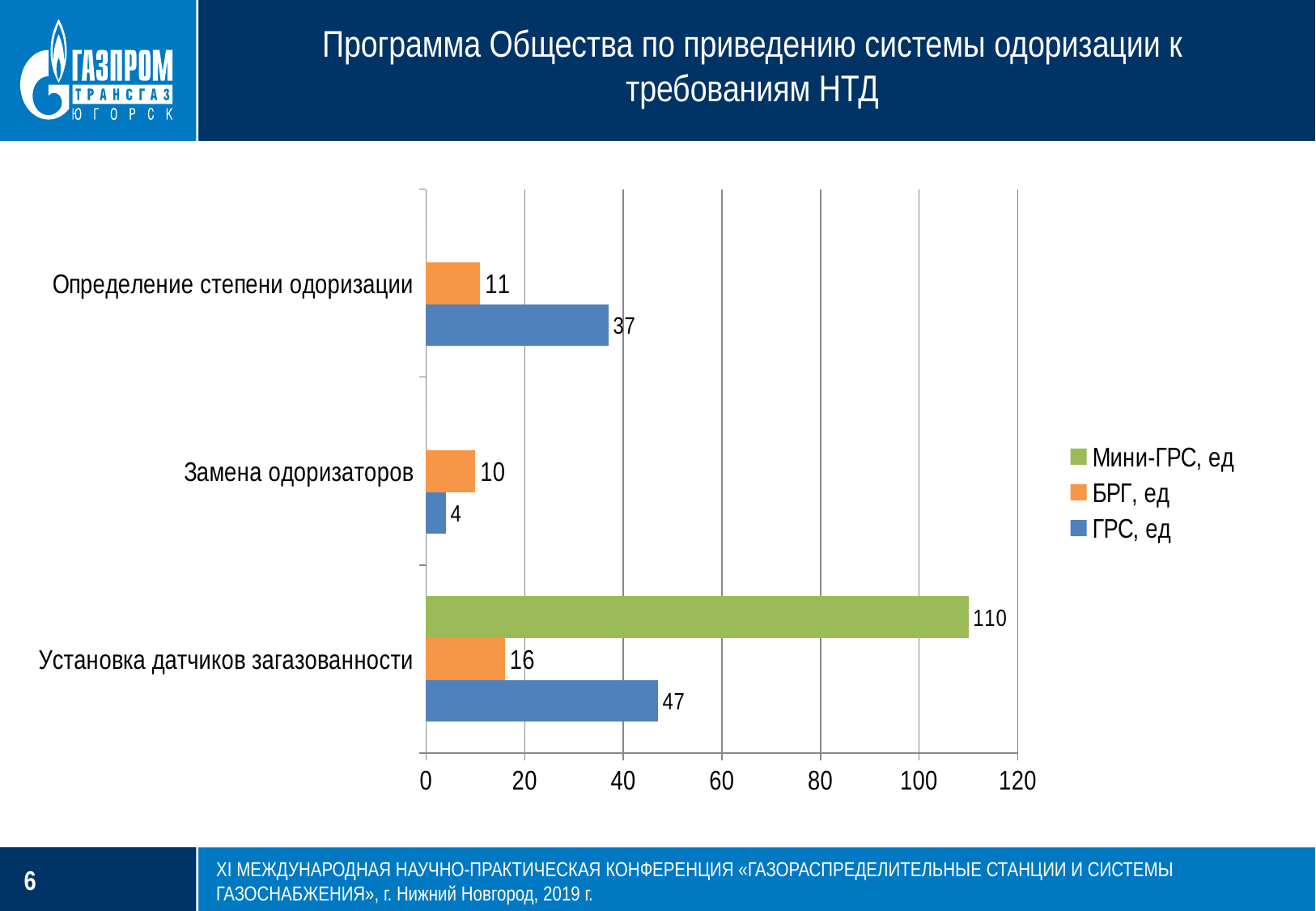
How many categories are shown on the chart? 3 What kind of chart is shown on the slide? bar chart Which category has the lowest value for ГРС, ед? Замена одоризаторов What is the value for Мини-ГРС, ед in the Установка датчиков загазованности category? 110 What is the value for БРГ, ед in the Замена одоризаторов category? 10 Is the value for Мини-ГРС, ед in the Установка датчиков загазованности category greater or less than 100? greater How many series does the legend list? 3 What is the difference between the ГРС, ед value and the БРГ, ед value in the Определение степени одоризации category? 26 What is the value for ГРС, ед in the Установка датчиков загазованности category? 47 In the Замена одоризаторов category, which is larger: the БРГ, ед value or the ГРС, ед value? БРГ, ед Which category has the highest value for ГРС, ед? Установка датчиков загазованности What is the value for ГРС, ед in the Определение степени одоризации category? 37